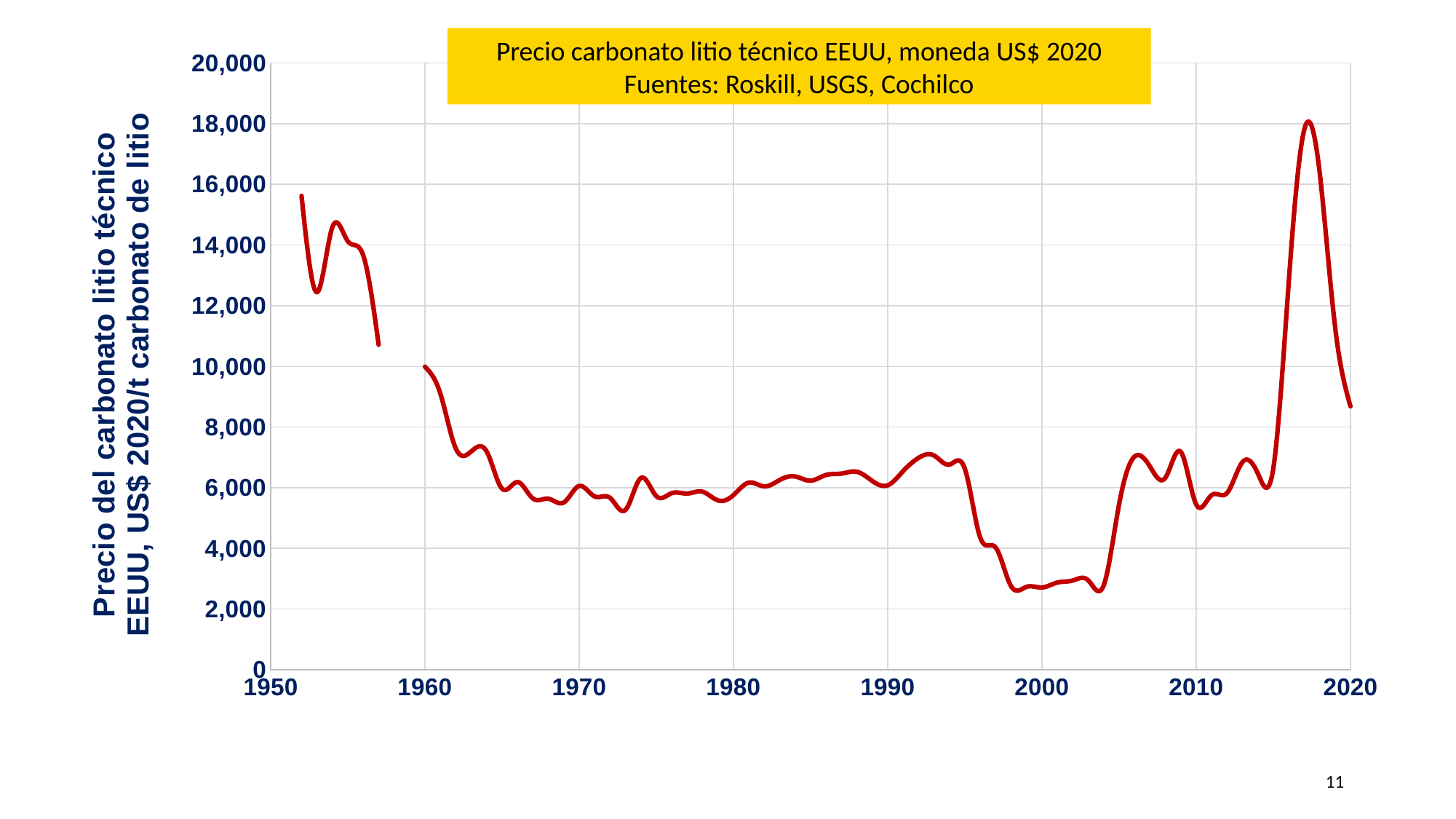
What kind of chart is shown on the slide? line chart Does the line rise or fall between 1960 and 1965? fall Is the value for 2000 greater or less than 4,000? less What is the title of the chart? Precio carbonato litio técnico EEUU, moneda US$ 2020 Does the line rise or fall between 2015 and 2017? rise Is the value for 1990 greater or less than 4,000? greater Is the highest value reached by the line greater or less than 16,000? greater Is the lowest point of the line reached before or after 1990? after Is the highest point of the line reached before or after 2010? after What sources are listed in the chart's title box? Roskill, USGS, Cochilco